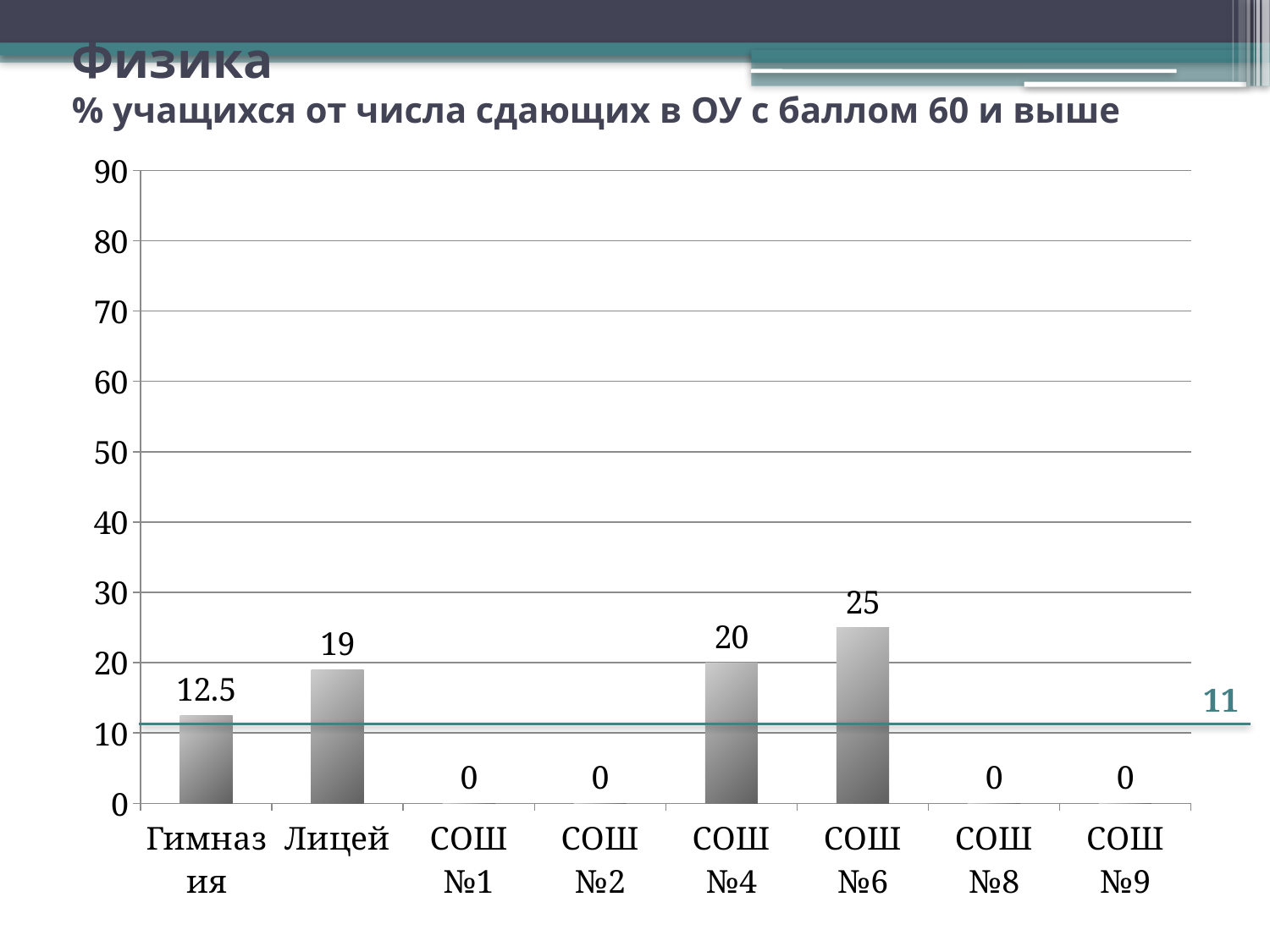
What kind of chart is shown on the slide? bar chart How many categories have a value of 0? 4 What is the value for Лицей? 19 Which category has the highest value? СОШ №6 Which is larger, the value for Лицей or the value for СОШ №4? СОШ №4 Is the value for СОШ №6 greater or less than 20? greater What is the value for Гимназия? 12.5 How many categories are shown on the x axis? 8 What is the value for СОШ №4? 20 What is the value for СОШ №6? 25 What is the difference between the values for СОШ №4 and Гимназия? 7.5 What is the difference between the values for СОШ №6 and Лицей? 6